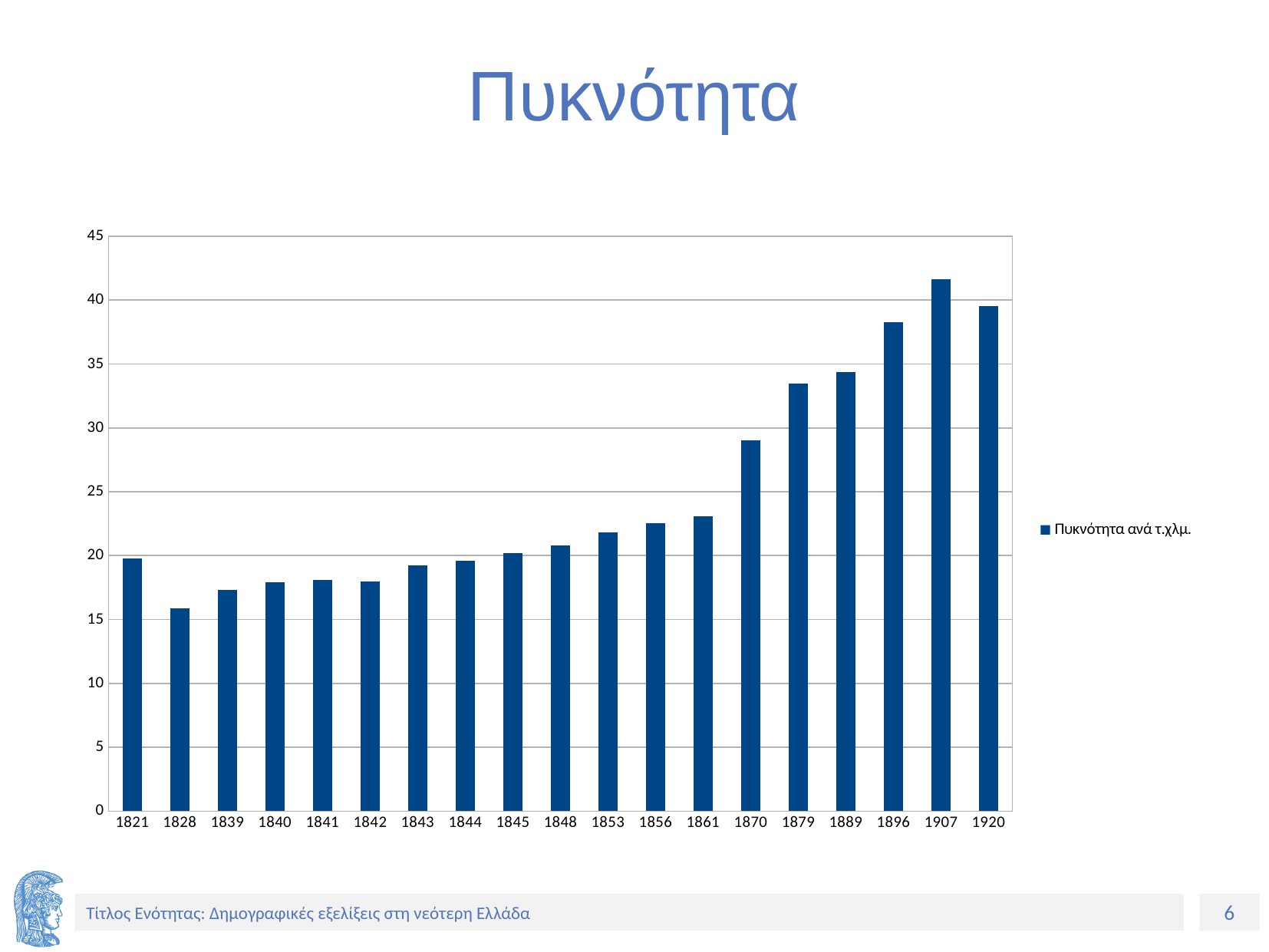
Do the values generally rise or fall from 1842 to 1907 along the x axis? rise How many series does the chart's legend list? 1 Is the value for 1828 greater or less than 20? less Which year has the lowest value in the chart? 1828 What kind of chart is shown on the slide? Bar chart Which has the larger value, 1861 or 1870? 1870 Is the value for 1879 greater or less than 30? greater What is the legend entry of the series shown in the chart? Πυκνότητα ανά τ.χλμ. Which has the larger value, 1907 or 1920? 1907 How many years (categories) are shown on the x axis of the chart? 19 Is the value for 1896 greater or less than 35? greater Which year has the highest value in the chart? 1907